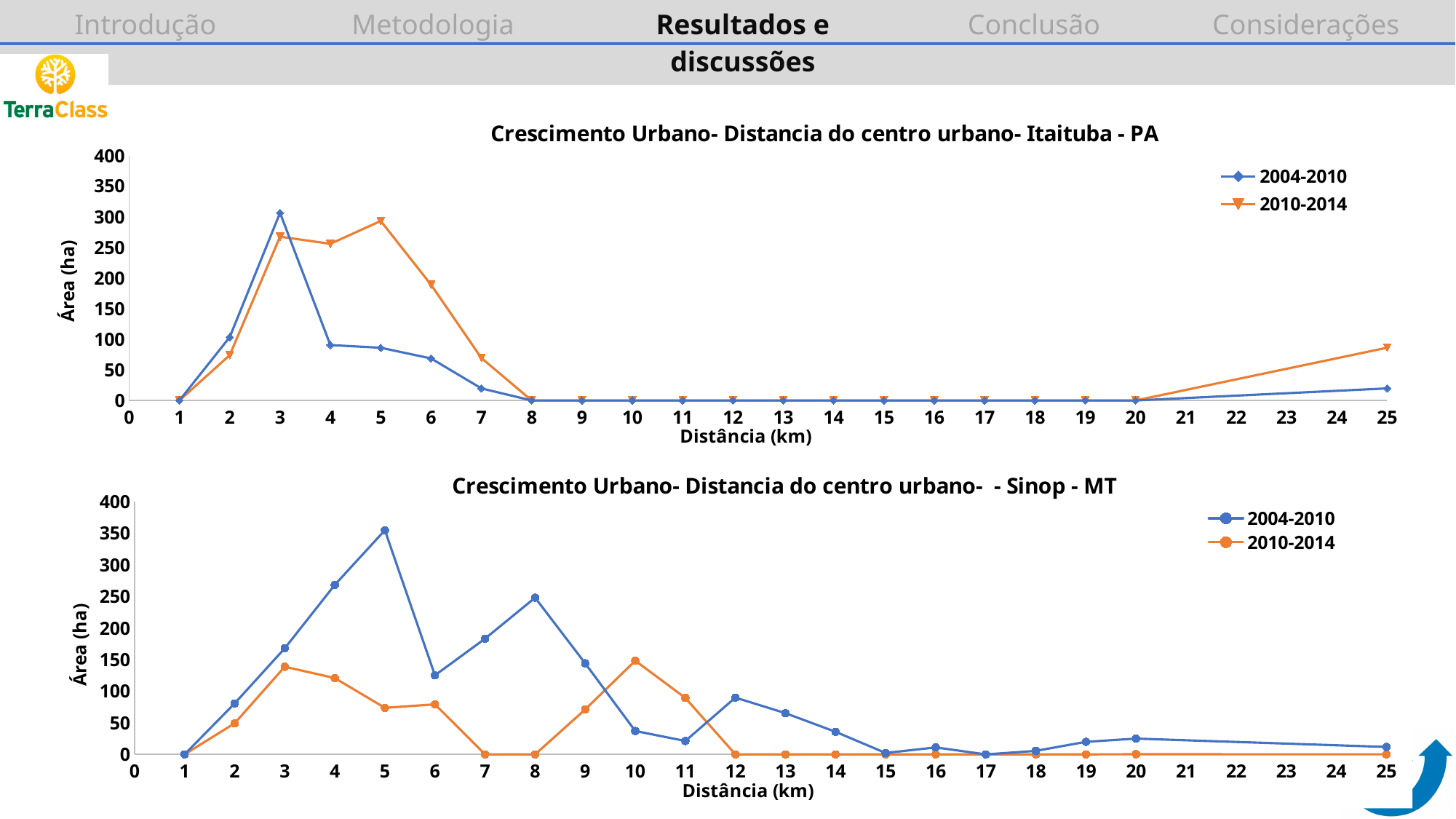
In the bottom chart (Sinop - MT), is the 2004-2010 value at 5 km greater or less than 300? greater In the top chart (Itaituba - PA), is the 2004-2010 value at 3 km greater or less than 250? greater In the bottom chart (Sinop - MT), which series has the larger value at 10 km, 2004-2010 or 2010-2014? 2010-2014 What is the label of the x axis on the bottom chart (Sinop - MT)? Distância (km) What kind of chart is the top chart titled 'Crescimento Urbano- Distancia do centro urbano- Itaituba - PA'? line chart In the bottom chart (Sinop - MT), at which distance does the 2004-2010 series reach its highest value? 5 km In the top chart (Itaituba - PA), at which distance does the 2010-2014 series reach its highest value? 5 km In the top chart (Itaituba - PA), which series has the larger value at 5 km, 2004-2010 or 2010-2014? 2010-2014 In the bottom chart (Sinop - MT), at which distance does the 2010-2014 series reach its highest value? 10 km In the top chart (Itaituba - PA), how many series does the legend list? 2 In the top chart (Itaituba - PA), does the 2004-2010 series rise or fall between 3 km and 8 km? fall